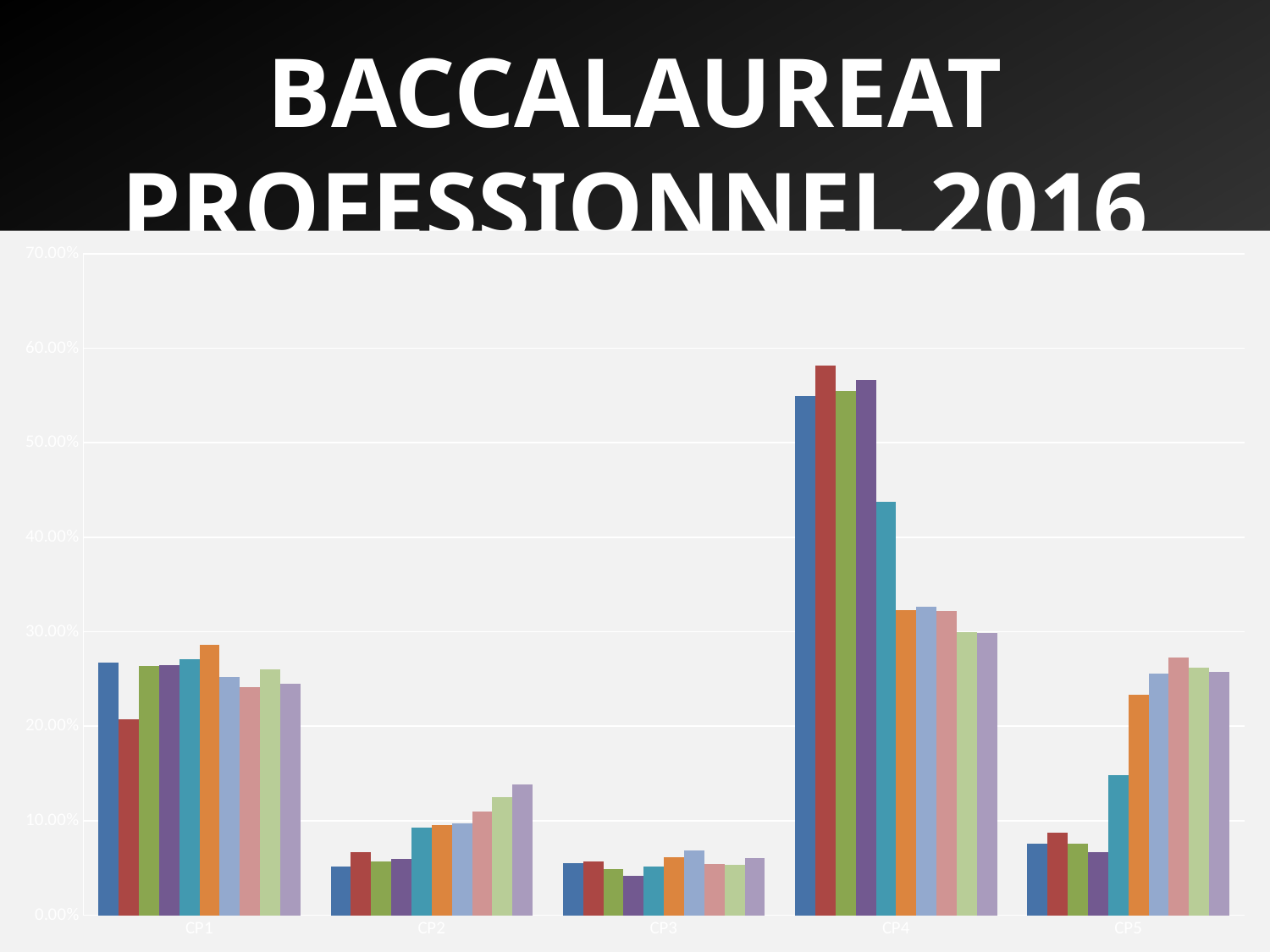
How many categories are shown on the x axis of the chart? 5 How many bars are plotted for each category? 10 Which category has the larger tallest bar, CP2 or CP5? CP5 What is the highest value shown on the y axis of the chart? 70.00% Which category has the larger tallest bar, CP1 or CP4? CP4 Which category contains the tallest bar in the chart? CP4 Is the tallest bar in CP4 greater or less than 50.00%? greater What kind of chart is shown on the slide? bar chart Is the first (dark blue) bar in CP5 greater or less than 10.00%? less What is the title of the slide containing the chart? BACCALAUREAT PROFESSIONNEL 2016 Are all the bars in CP3 greater or less than 10.00%? less